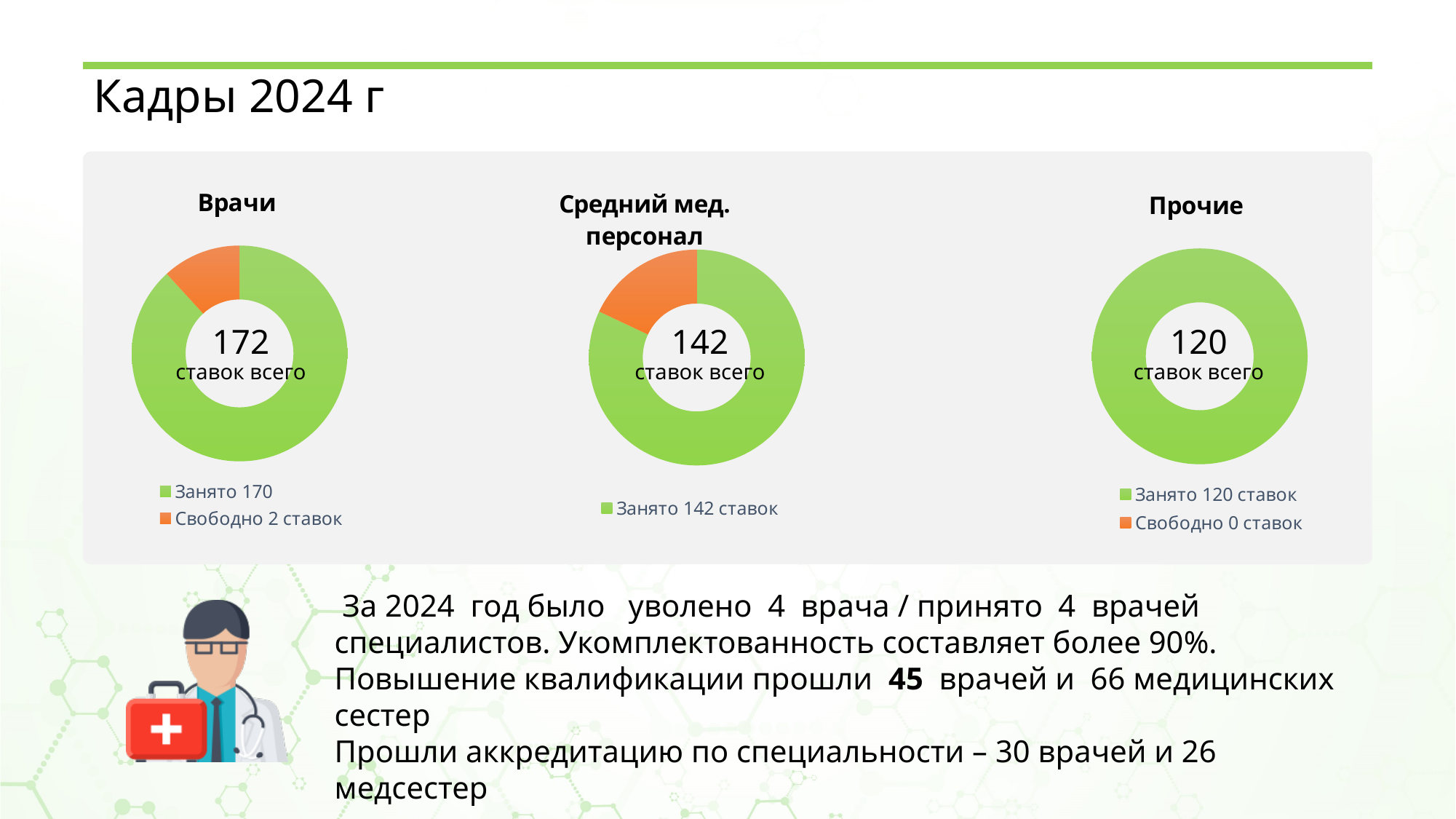
In the "Средний мед. персонал" chart, how many positions does the legend say are "Занято"? 142 In the "Средний мед. персонал" chart, what total number of positions is shown in the centre? 142 In the "Прочие" chart, what total number of positions is shown in the centre? 120 In the "Прочие" chart, how many positions are listed as "Свободно" in the legend? 0 In the "Врачи" chart, how many positions are listed as "Свободно" in the legend? 2 In the "Врачи" chart, what total number of positions (ставок всего) is shown in the centre? 172 Which chart shows the larger total number of positions, "Врачи" or "Прочие"? Врачи How many donut charts are shown on the slide? 3 What kind of chart is used for "Врачи"? doughnut chart What is the difference between the total positions in the "Врачи" chart and the "Прочие" chart? 52 How many entries does the legend of the "Врачи" chart list? 2 In the "Врачи" chart, how many positions are listed as "Занято" in the legend? 170